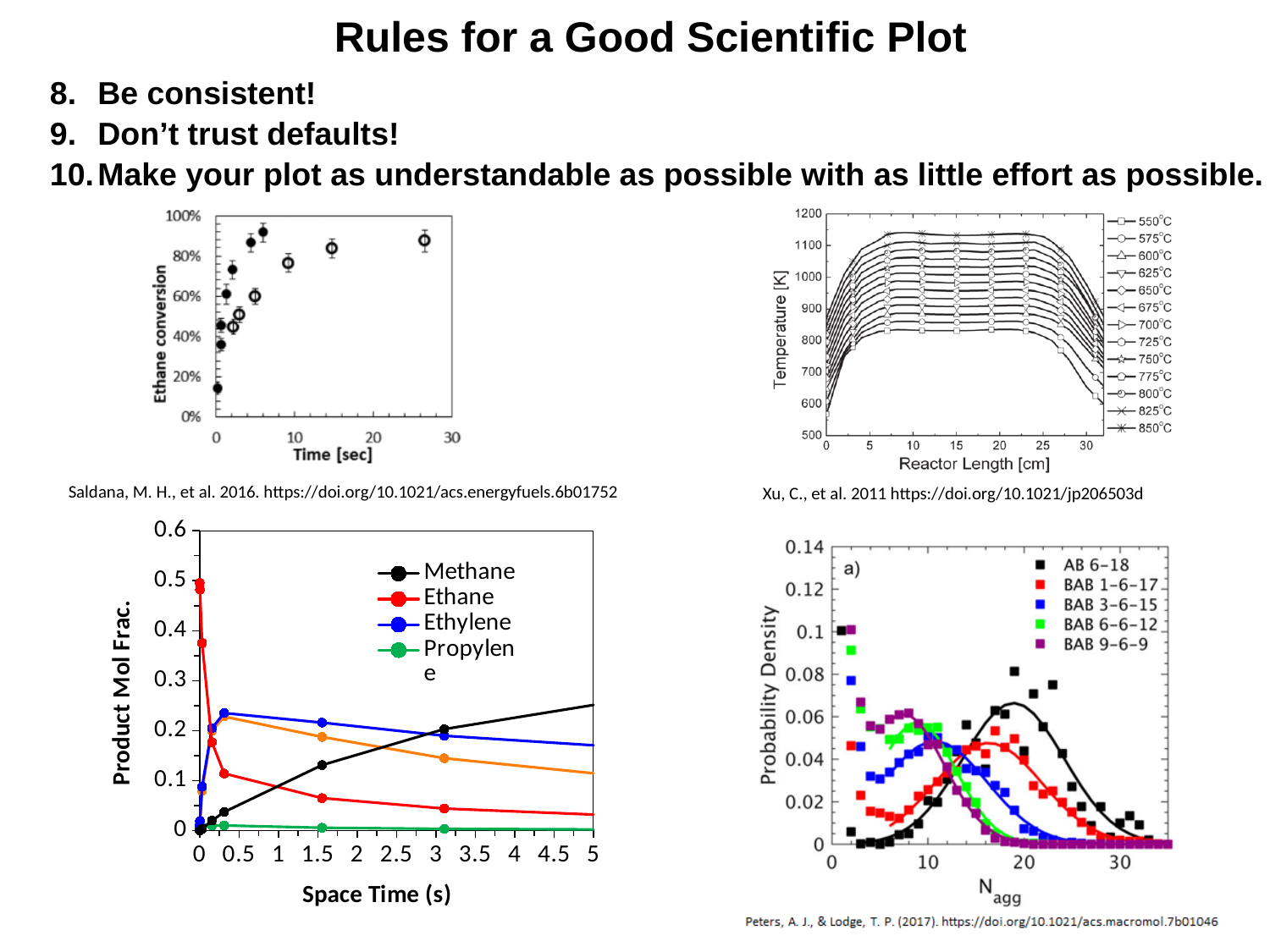
In the bottom-right chart (Probability Density vs N_agg), how many series does the legend list? 5 In the top-right chart (Temperature vs Reactor Length), how many series does the legend list? 13 In the bottom-left chart (Product Mol Frac. vs Space Time), is the Ethane value at Space Time 0 greater or less than 0.4? greater In the bottom-left chart (Product Mol Frac. vs Space Time), does the Methane value rise or fall as Space Time increases? rise In the bottom-left chart (Product Mol Frac. vs Space Time), what kind of chart is it? line chart In the bottom-left chart (Product Mol Frac. vs Space Time), how many series does the legend list? 4 In the bottom-left chart (Product Mol Frac. vs Space Time), does the Ethane value rise or fall as Space Time increases? fall In the top-right chart (Temperature vs Reactor Length), is the peak of the 850°C curve greater or less than 1100 K? greater In the bottom-left chart (Product Mol Frac. vs Space Time), at Space Time 5, which is larger, Methane or Ethylene? Methane In the top-right chart (Temperature vs Reactor Length), what is the y-axis label? Temperature [K] In the top-left chart (Ethane conversion vs Time), does ethane conversion generally rise or fall as time increases? rise